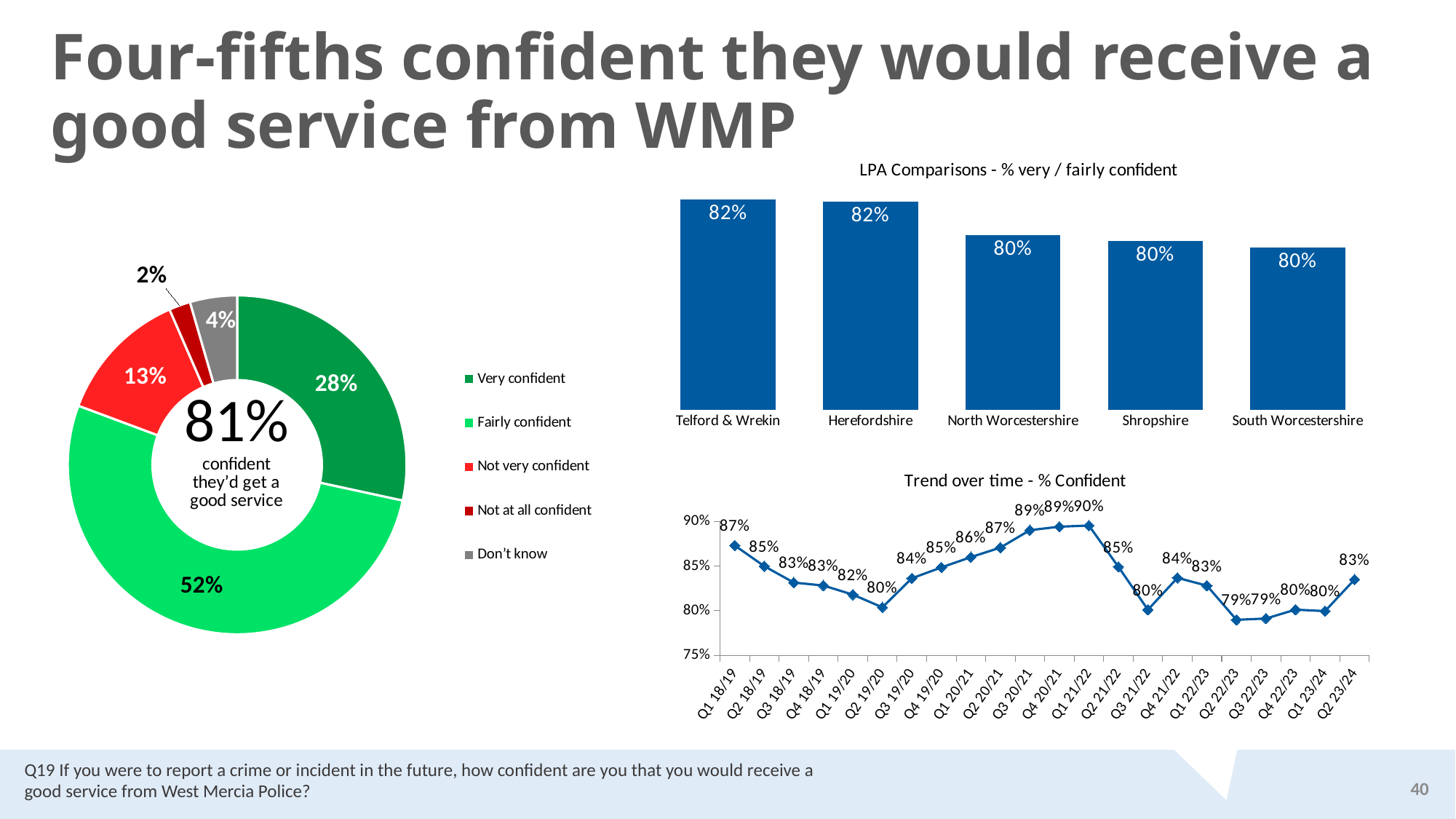
In the 'Trend over time - % Confident' chart, which quarter has the highest value? Q1 21/22 In the 'Trend over time - % Confident' chart, what is the value for Q1 21/22? 90% In the 'LPA Comparisons - % very / fairly confident' chart, what is the difference between Telford & Wrekin and Shropshire? 2 percentage points How many categories does the legend of the donut chart on the left list? 5 In the 'LPA Comparisons - % very / fairly confident' chart, what is the value for Herefordshire? 82% In the donut chart on the left, what percentage are 'Not very confident'? 13% In the donut chart on the left, which category has the smallest share? Not at all confident How many LPAs are shown in the 'LPA Comparisons - % very / fairly confident' chart? 5 What type of chart is the 'LPA Comparisons - % very / fairly confident' chart? Bar chart In the 'Trend over time - % Confident' chart, what is the value for Q2 23/24? 83% In the 'Trend over time - % Confident' chart, is the value for Q2 22/23 greater or less than Q1 18/19? less In the donut chart on the left, what percentage are 'Fairly confident'? 52%